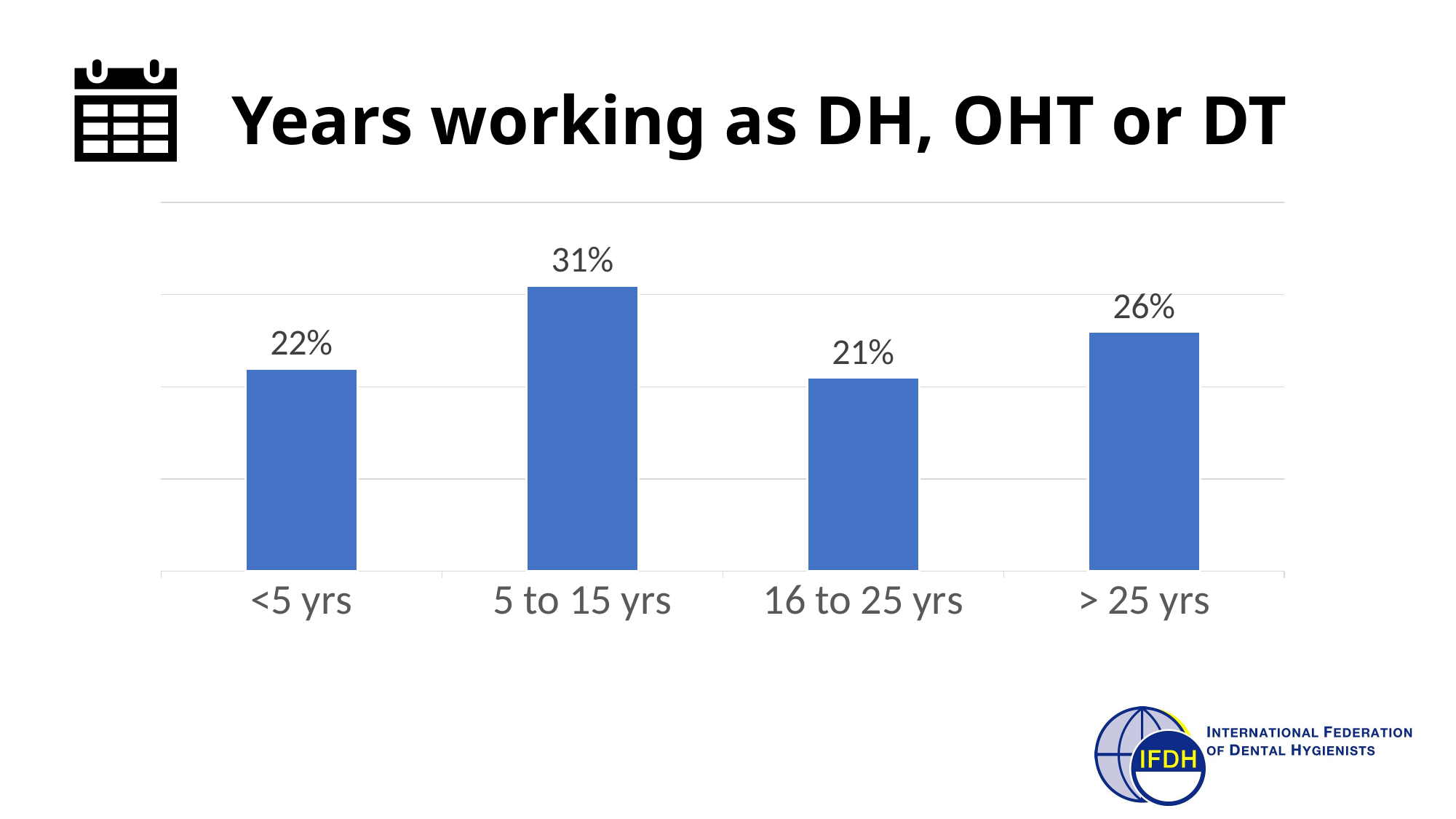
What is the title of the chart on the slide? Years working as DH, OHT or DT Which category has the lowest percentage? 16 to 25 yrs What is the value for the '> 25 yrs' category? 26% What percentage of respondents have worked less than 5 years as DH, OHT or DT? 22% Which category has the highest percentage? 5 to 15 yrs What percentage is shown for '16 to 25 yrs'? 21% How many categories are shown on the chart? 4 What kind of chart is shown on the slide? Bar chart What is the difference between the '5 to 15 yrs' and '16 to 25 yrs' values? 10% Which is larger, the value for '<5 yrs' or the value for '> 25 yrs'? > 25 yrs What is the difference between the '> 25 yrs' and '<5 yrs' values? 4% What is the value shown for the '5 to 15 yrs' category? 31%